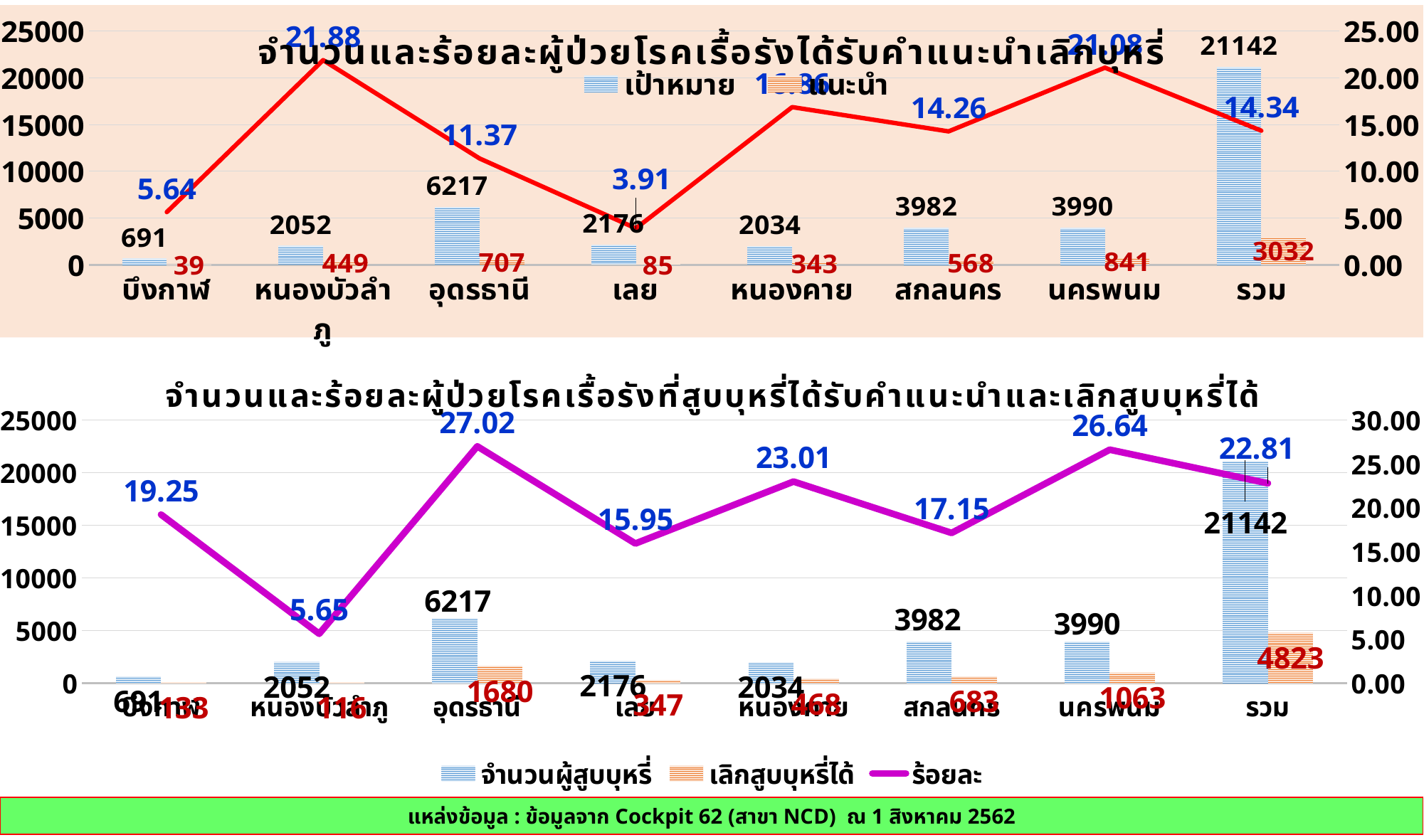
In the bottom chart, which province (excluding รวม) has the highest percentage on the line? อุดรธานี In the top chart, which province (excluding รวม) has the lowest percentage on the line? เลย In the top chart, what is the difference between the เป้าหมาย and แนะนำ values for รวม? 18110 In the bottom chart, which is larger: the เลิกสูบบุหรี่ได้ value for สกลนคร or for นครพนม? นครพนม How many series does the legend of the bottom chart list? 3 In the top chart, what is the value of the เป้าหมาย bar for อุดรธานี? 6217 How many categories are shown on the x axis of the bottom chart? 8 In the top chart, what is the value of the แนะนำ bar for นครพนม? 841 In the bottom chart, what percentage is shown on the line for นครพนม? 26.64 In the bottom chart, what is the value of the เลิกสูบบุหรี่ได้ bar for อุดรธานี? 1680 In the top chart, what percentage is shown on the line for หนองบัวลำภู? 21.88 What colour is the percentage line in the bottom chart? Purple